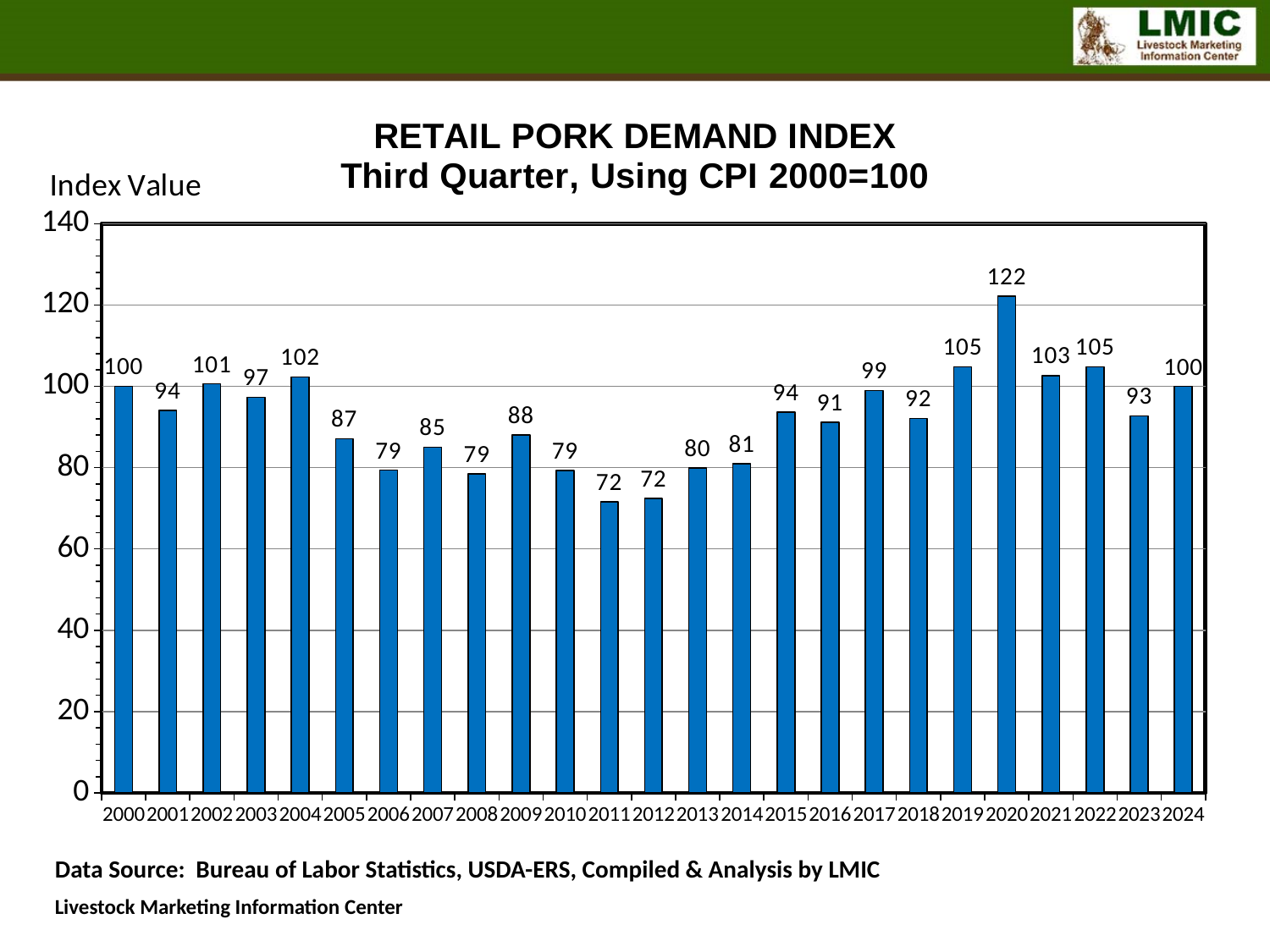
What is the label on the y axis of the chart? Index Value How many years are shown on the x axis? 25 What is the difference between the index values for 2020 and 2019? 17 Which year has a larger index value, 2005 or 2015? 2015 What is the retail pork demand index value for 2020? 122 What kind of chart is shown on the slide? bar chart What is the index value shown for 2024? 100 What is the index value shown for 2011? 72 Do the index values rise or fall from 2011 to 2020? rise Is the index value for 2023 greater or less than 100? less What is the difference between the index values for 2022 and 2023? 12 Which year has the highest index value? 2020